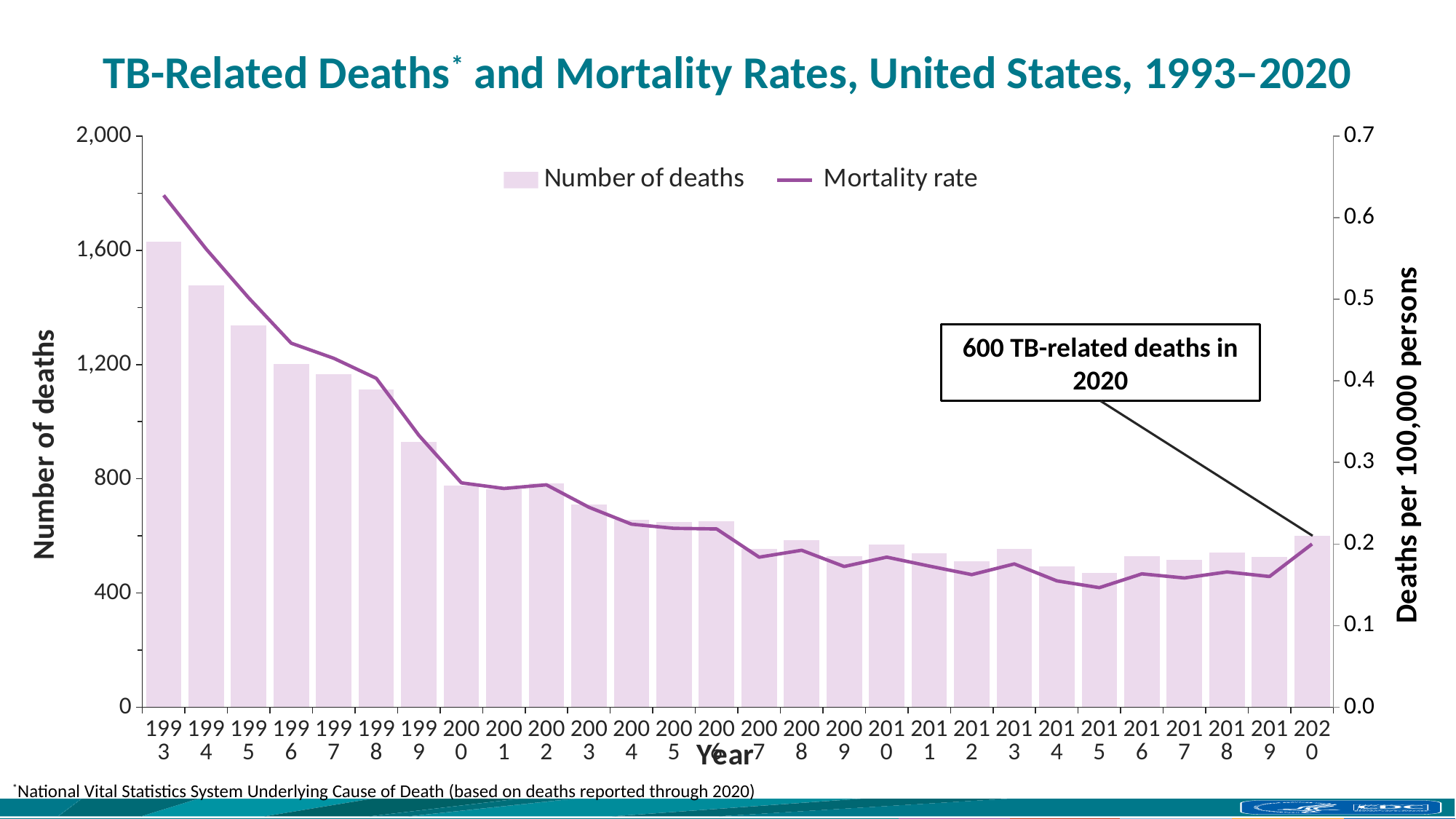
Is the number of deaths in 1993 greater or less than 1,200? greater Is the mortality rate in 1993 greater or less than 0.6? greater What kind of chart is shown on the slide? A bar chart combined with a line chart According to the callout on the chart, how many TB-related deaths were there in 2020? 600 How many years are shown along the x axis of the chart? 28 Which year has the highest number of deaths? 1993 Does the number of deaths generally rise or fall from 1993 to 2020? Fall What is the title of the right-hand vertical axis? Deaths per 100,000 persons Which year has the highest mortality rate? 1993 Is the mortality rate in 2020 greater or less than 0.3? less How many series does the chart's legend list? 2 Which year had more deaths, 1994 or 1995? 1994